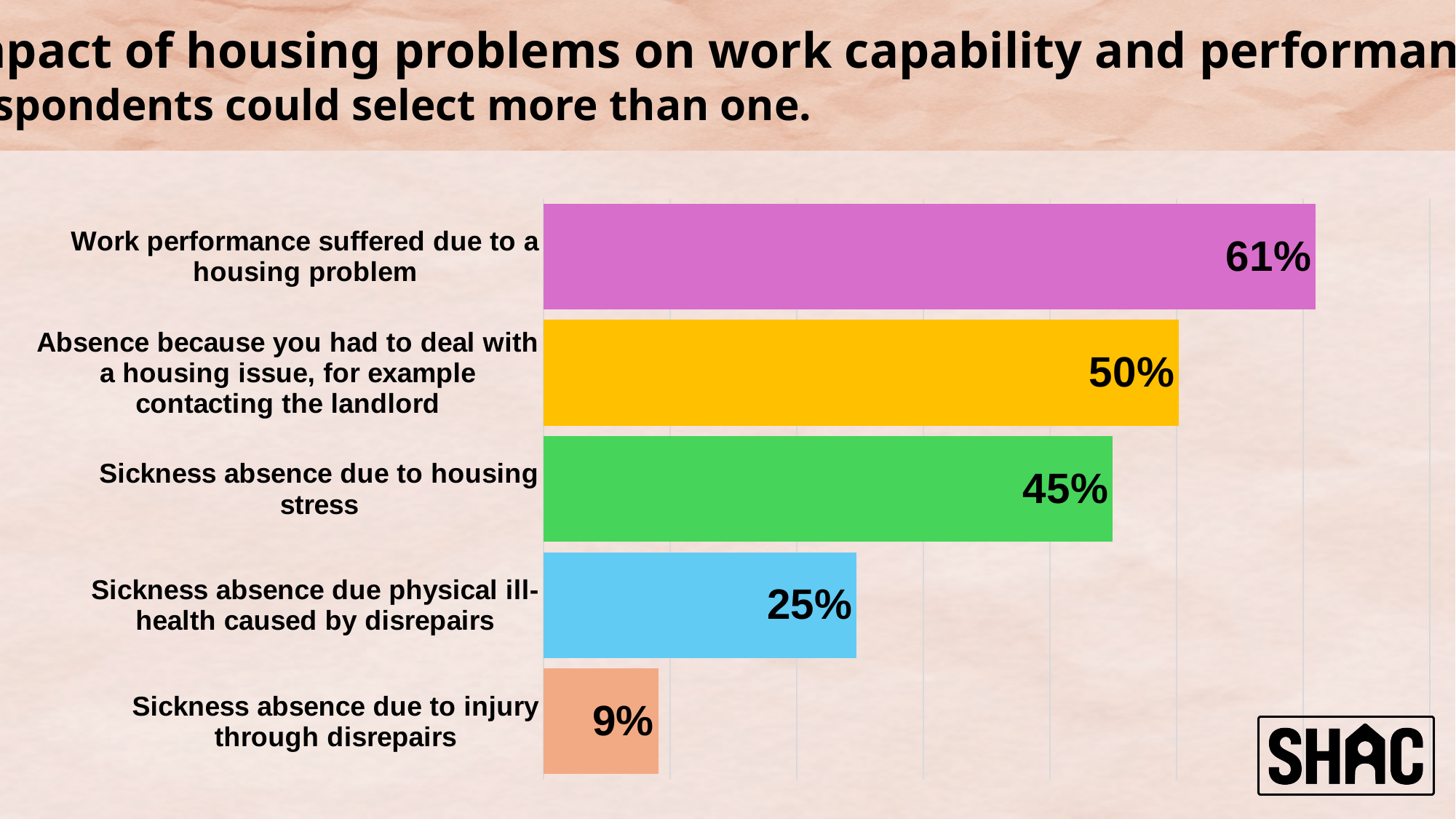
What colour is the bar for 'Sickness absence due to housing stress'? Green What percentage of respondents said their work performance suffered due to a housing problem? 61% What is the value for 'Sickness absence due to housing stress'? 45% What percentage reported sickness absence due to injury through disrepairs? 9% What is the difference between the value for 'Work performance suffered due to a housing problem' and 'Sickness absence due to housing stress'? 16% Which category has the highest value? Work performance suffered due to a housing problem Which is larger: the value for 'Absence because you had to deal with a housing issue' or 'Sickness absence due to housing stress'? Absence because you had to deal with a housing issue Which category has the lowest value? Sickness absence due to injury through disrepairs How many categories are shown in the chart? 5 What is the difference between 'Sickness absence due physical ill-health caused by disrepairs' and 'Sickness absence due to injury through disrepairs'? 16% What is the value for 'Absence because you had to deal with a housing issue, for example contacting the landlord'? 50% What kind of chart is shown on the slide? Bar chart